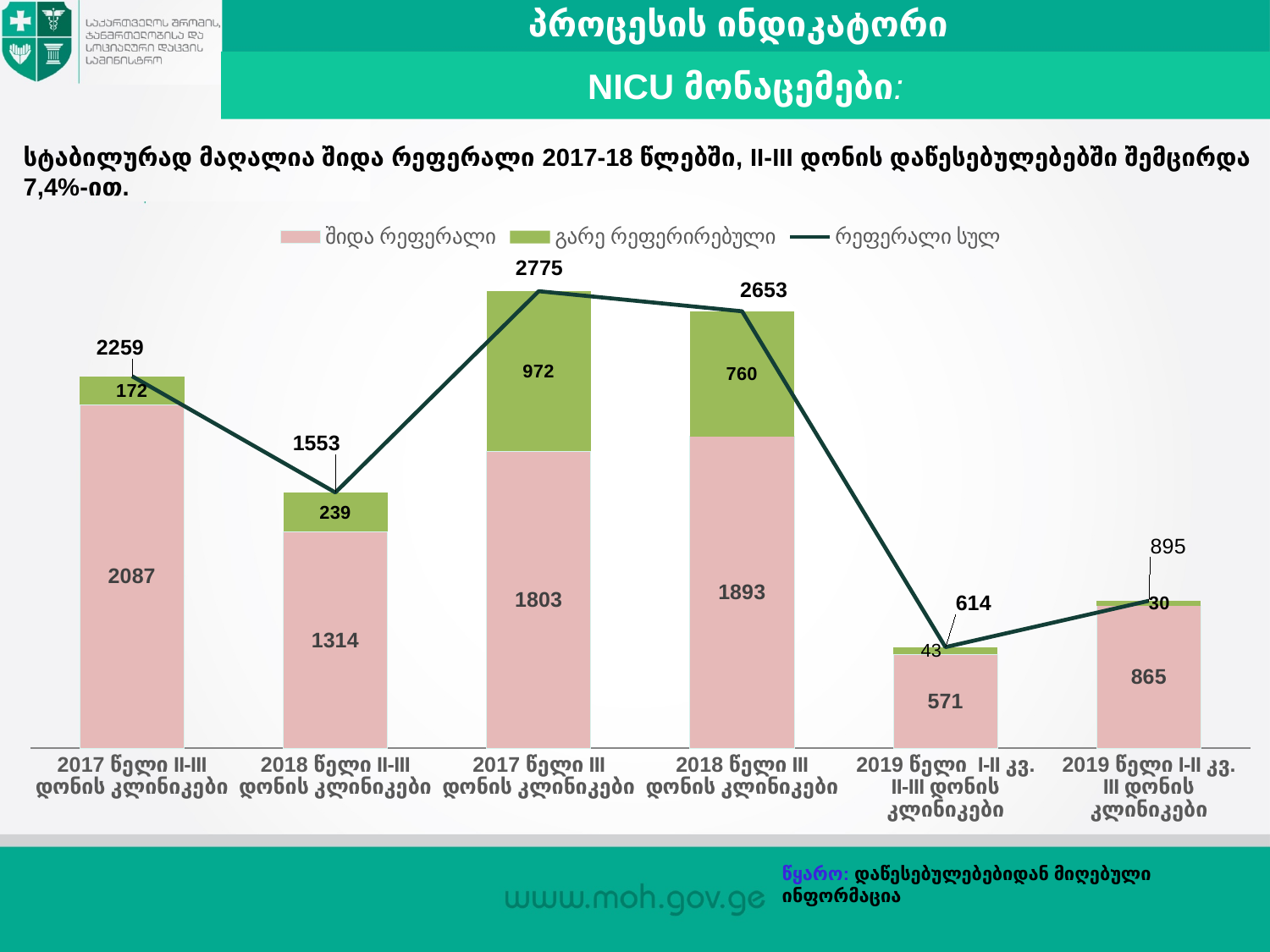
Which series is shown in green in the legend? გარე რეფერირებული Which category has the lowest რეფერალი სულ value? 2019 წელი I-II კვ. II-III დონის კლინიკები What is the value of შიდა რეფერალი for 2017 წელი II-III დონის კლინიკები? 2087 How many categories are shown on the x axis? 6 Which is larger: შიდა რეფერალი for 2018 წელი III დონის კლინიკები or for 2017 წელი III დონის კლინიკები? 2018 წელი III დონის კლინიკები What is the total of the stacked bar for 2019 წელი I-II კვ. III დონის კლინიკები? 895 Which category has the highest რეფერალი სულ value? 2017 წელი III დონის კლინიკები What kind of chart is shown on the slide? Stacked bar chart with a line What is the difference between the რეფერალი სულ values for 2017 წელი III დონის კლინიკები and 2018 წელი III დონის კლინიკები? 122 How many series does the legend list? 3 What is the value of რეფერალი სულ for 2018 წელი II-III დონის კლინიკები? 1553 What is the value of გარე რეფერირებული for 2017 წელი III დონის კლინიკები? 972